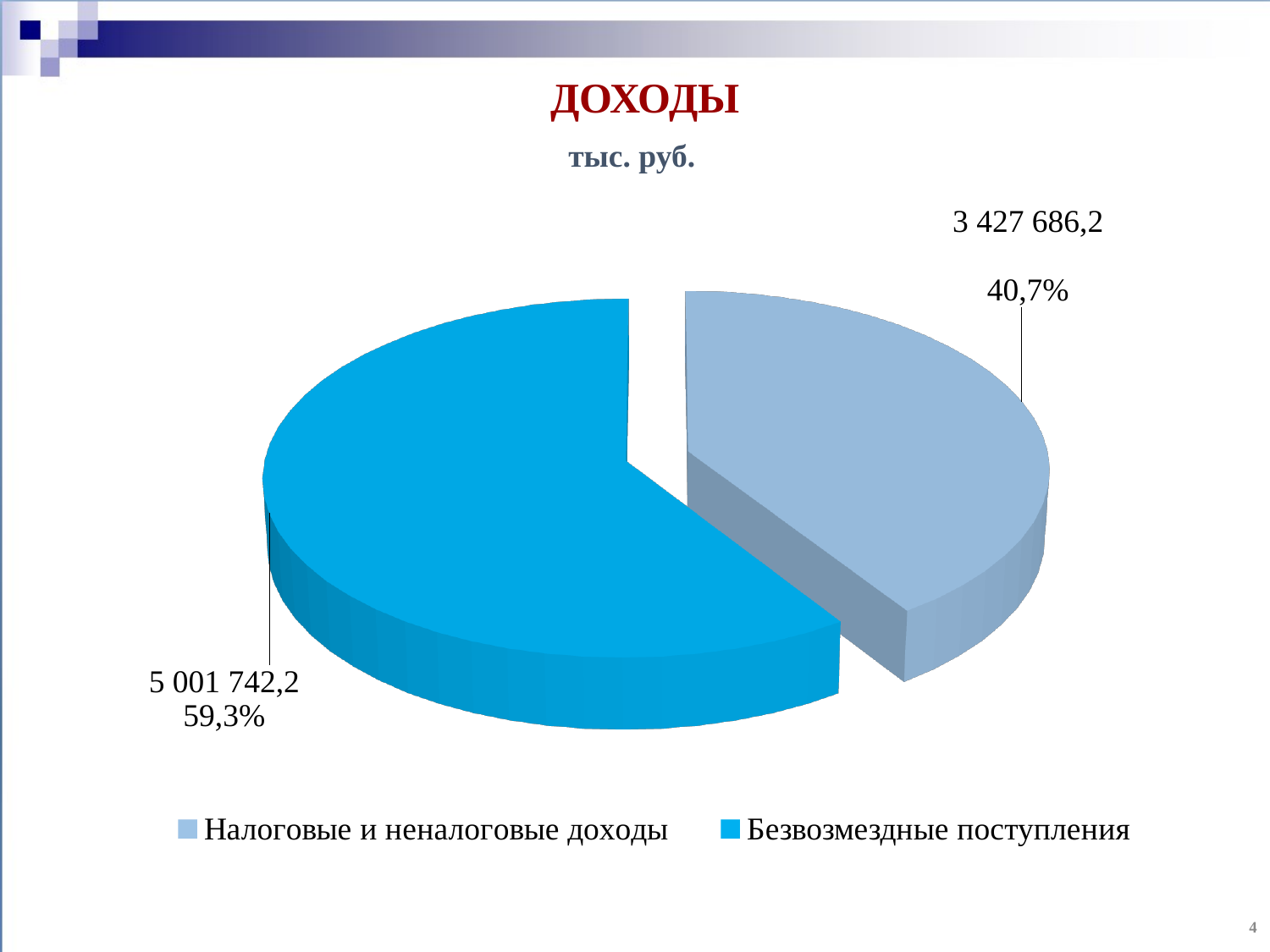
What is the title of the chart? ДОХОДЫ Which is larger: Налоговые и неналоговые доходы or Безвозмездные поступления? Безвозмездные поступления What is the difference between the values for Безвозмездные поступления and Налоговые и неналоговые доходы? 1 574 056,0 What is the value for Налоговые и неналоговые доходы? 3 427 686,2 In what units are the values on the chart given? тыс. руб. What share of the pie does Налоговые и неналоговые доходы represent? 40,7% What is the value for Безвозмездные поступления? 5 001 742,2 What kind of chart is shown on the slide? Pie chart What share of the pie does Безвозмездные поступления represent? 59,3% Which category has the largest slice of the pie? Безвозмездные поступления Which category has the smallest slice of the pie? Налоговые и неналоговые доходы How many slices does the pie chart have? 2